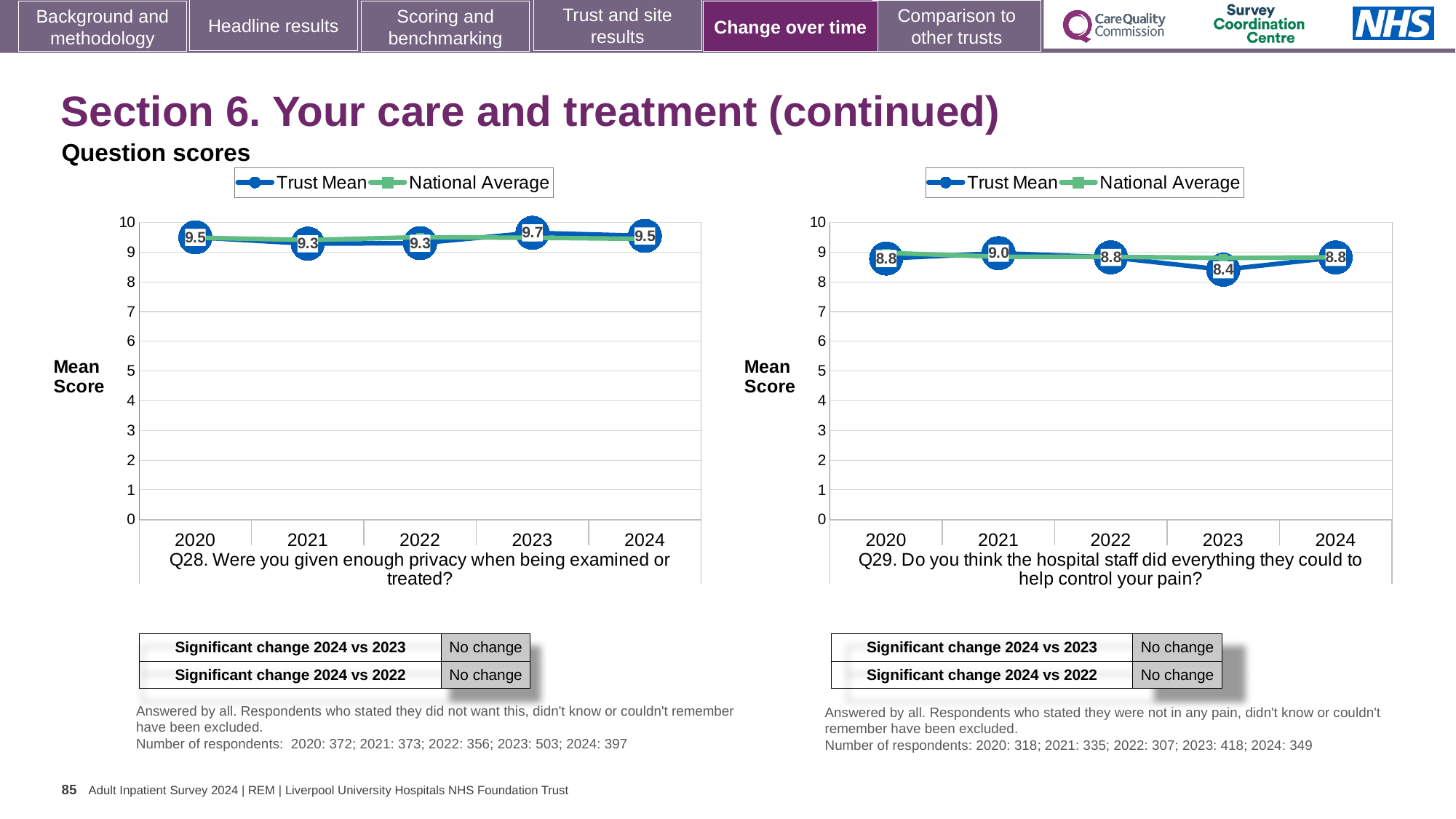
How many years are plotted on the x axis of the Q28 chart (left)? 5 On the Q29 chart (right), what is the difference between the Trust Mean scores for 2021 and 2023? 0.6 On the Q29 chart (right), what is the Trust Mean score for 2023? 8.4 On the Q28 chart (left), which year has the highest Trust Mean score? 2023 On the Q28 chart (left), what is the difference between the Trust Mean scores for 2023 and 2022? 0.4 How many series does the legend of the Q29 chart (right) list? 2 On the Q28 chart (left), what is the Trust Mean score for 2023? 9.7 On the Q28 chart (left), what is the Trust Mean score for 2021? 9.3 On the Q29 chart (right), what is the Trust Mean score for 2021? 9.0 What type of chart is used for Q28 (left)? Line chart Which is larger: the 2024 Trust Mean score on the Q28 chart (left) or the 2024 Trust Mean score on the Q29 chart (right)? Q28 chart (9.5) On the Q29 chart (right), which year has the lowest Trust Mean score? 2023